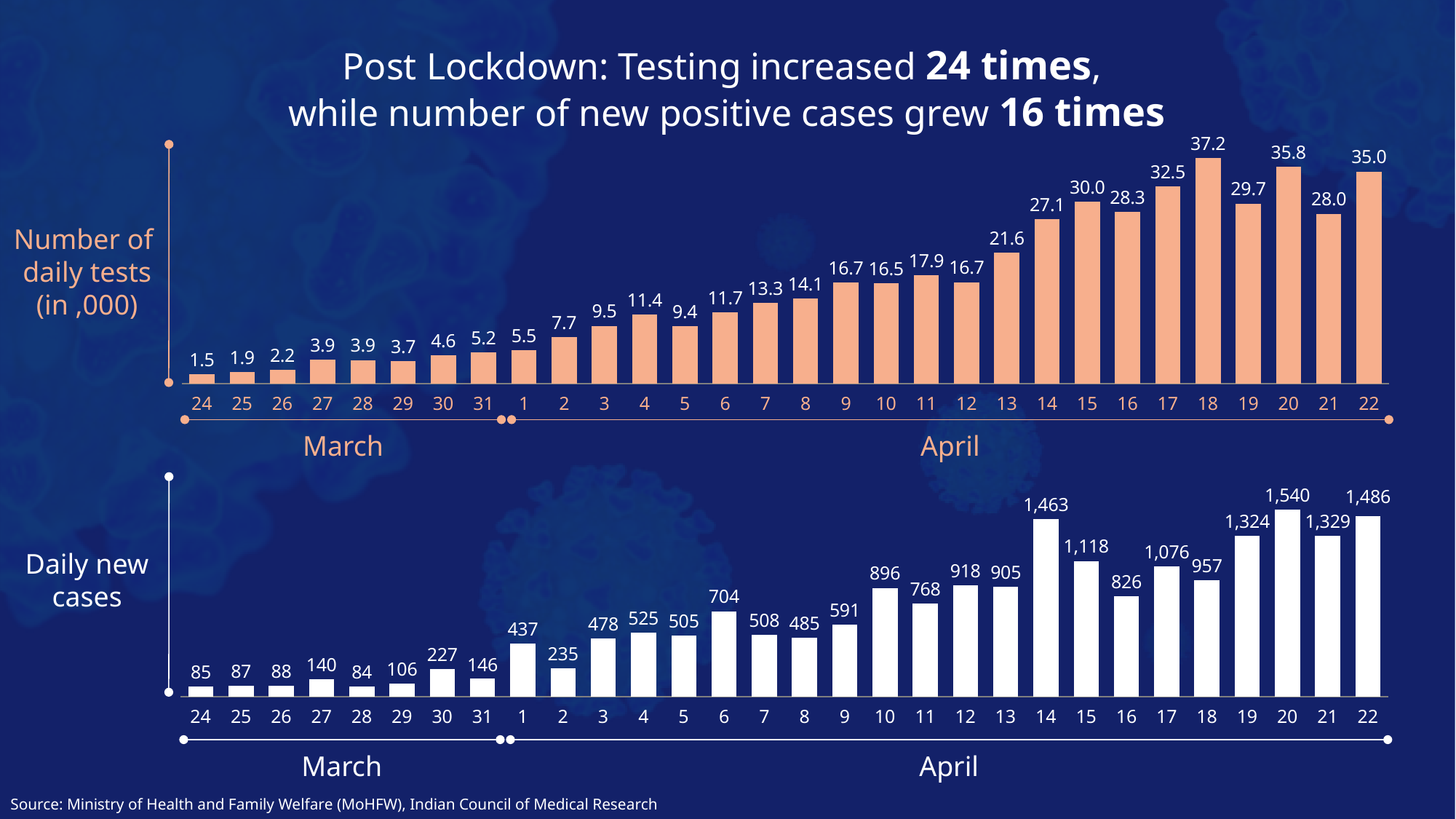
In the bottom chart (Daily new cases), what is the value for April 14? 1,463 In the bottom chart (Daily new cases), which date has the highest value? April 20 What type of chart is the bottom chart (Daily new cases)? Bar chart How many bars (dates) are plotted in the top chart (Number of daily tests)? 30 In the top chart (Number of daily tests), what is the value for April 18? 37.2 In the top chart (Number of daily tests), which date has the lowest value? March 24 In the top chart (Number of daily tests), what is the difference between the values for April 18 and April 19? 7.5 In the top chart (Number of daily tests), which date has the highest value? April 18 In the bottom chart (Daily new cases), which is larger: the value for April 6 or the value for April 7? April 6 In the bottom chart (Daily new cases), which date has the lowest value? March 28 In the top chart (Number of daily tests), do the values generally rise or fall from March 24 to April 22? Rise In the bottom chart (Daily new cases), what is the difference between the values for April 20 and April 21? 211